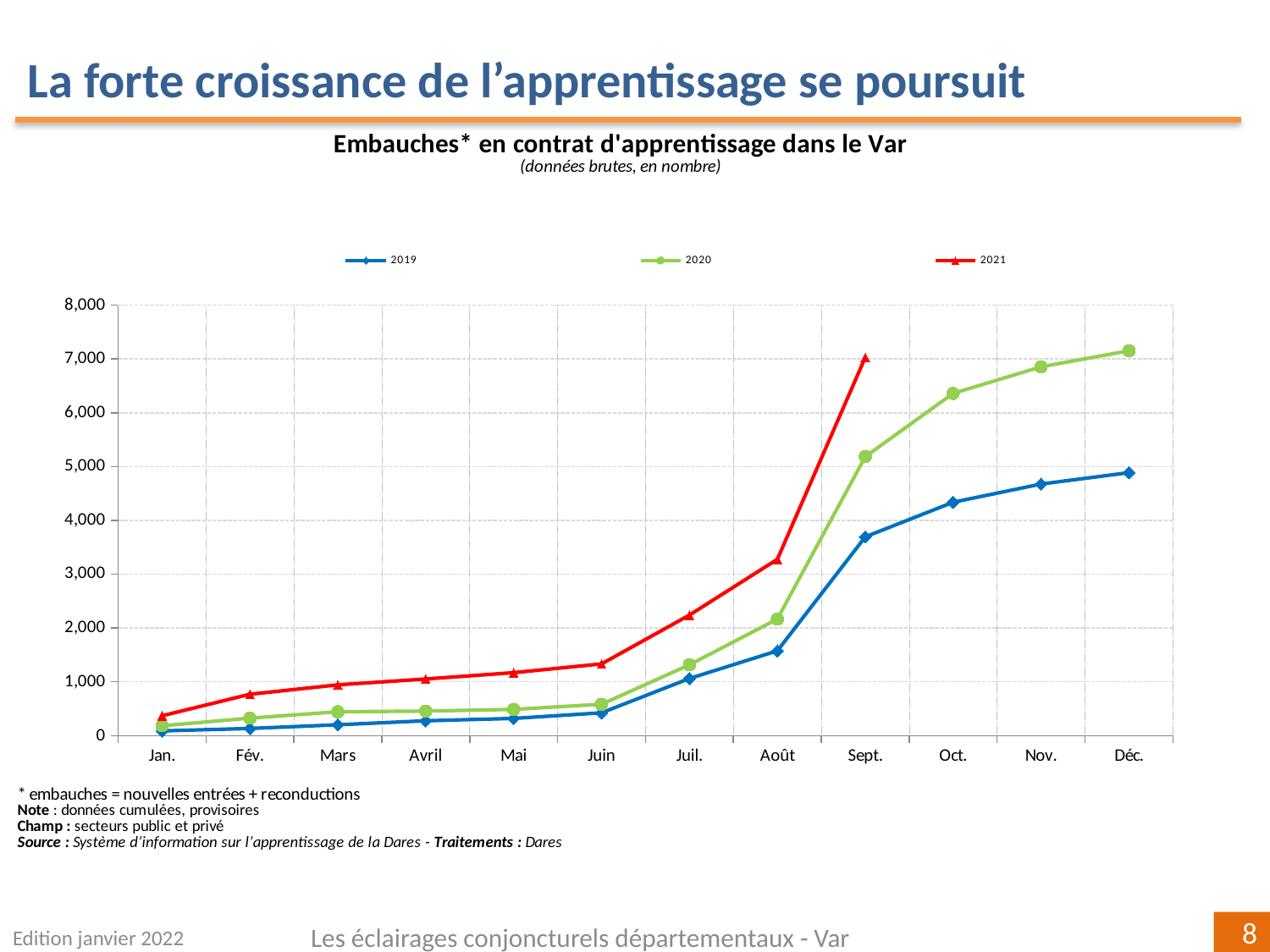
Is the value for 2019 in Déc. greater or less than 4,000? greater Is the value for 2021 in Sept. greater or less than 6,000? greater How many series does the legend list? 3 What kind of chart is shown on the slide? line chart Which series has the lowest value in Jan.? 2019 Is the value for 2020 in Déc. greater or less than 6,000? greater What is the last month for which the 2021 series has a data point? Sept. Which series has the highest value in Sept.? 2021 Do the values for the 2020 series rise or fall from Jan. to Déc.? rise In Juil., which series has the larger value, 2020 or 2021? 2021 How many months are shown along the x axis? 12